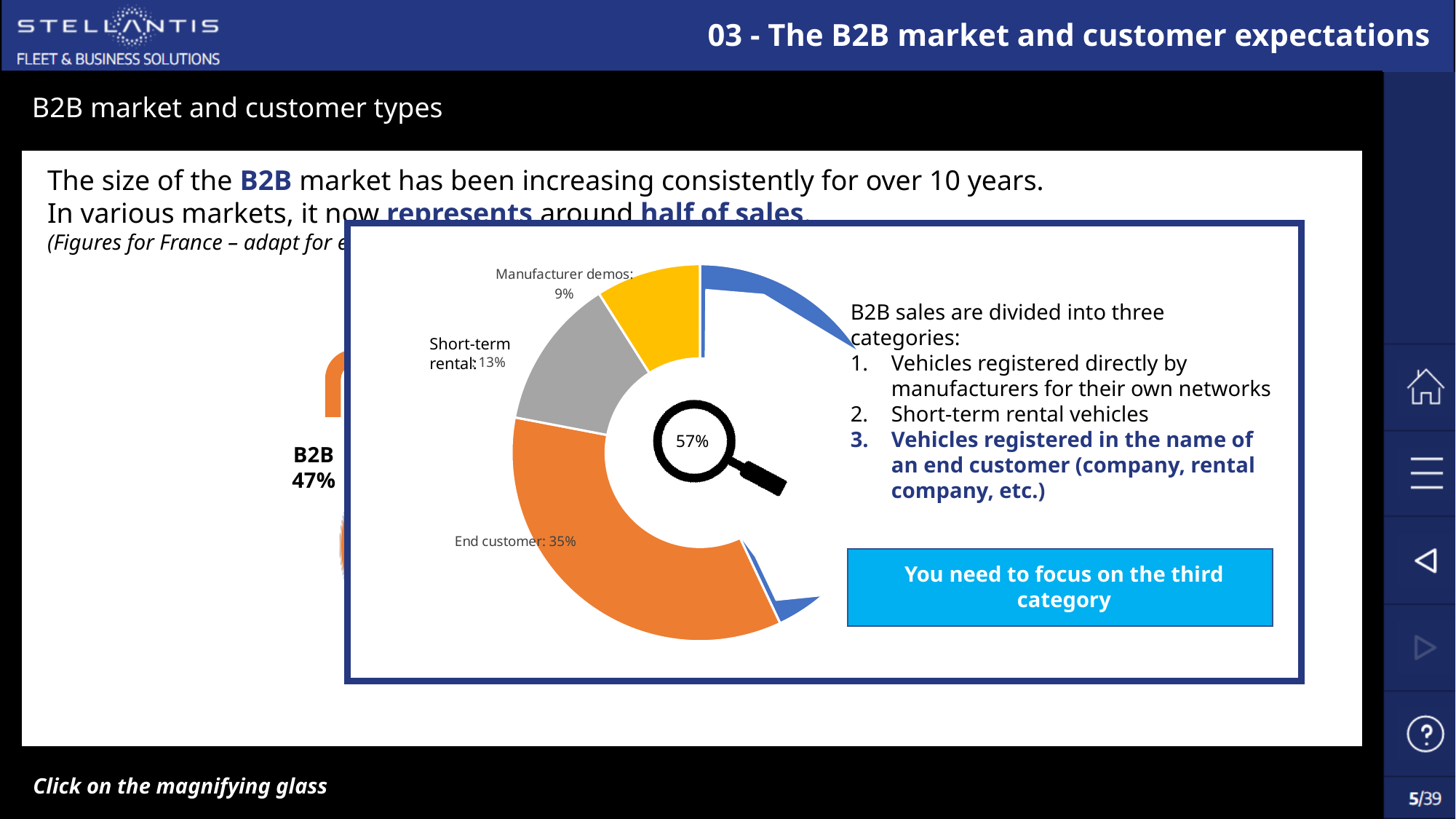
In the donut chart, which is larger: Short-term rental or Manufacturer demos? Short-term rental Which labelled category in the donut chart has the smallest share? Manufacturer demos In the donut chart, what is the difference between the End customer share and the Short-term rental share? 22% What value is printed in the centre of the donut chart? 57% In the donut chart, what percentage is shown for Manufacturer demos? 9% In the donut chart, what percentage is shown for Short-term rental? 13% In the donut chart, what percentage is shown for End customer? 35% How many labelled categories does the donut chart show? 3 Which labelled category in the donut chart has the largest share? End customer What colour is the End customer slice in the donut chart? Orange What is the combined share of the three labelled categories in the donut chart (Manufacturer demos, Short-term rental and End customer)? 57% What type of chart is shown in the pop-up box? Pie chart (donut)